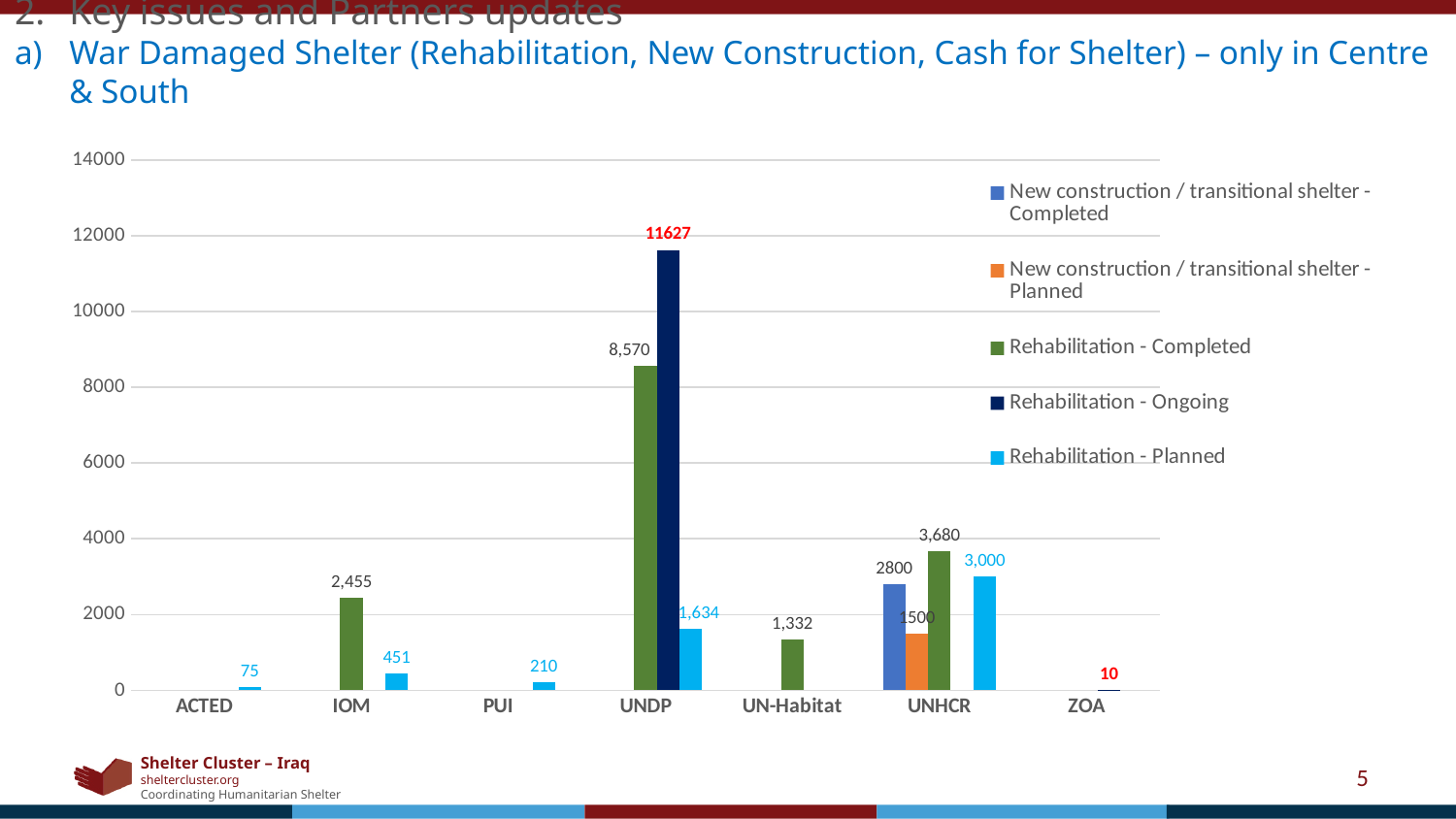
Which partner has the highest Rehabilitation - Completed value? UNDP How many partners are shown on the x axis? 7 What is the Rehabilitation - Planned value for UNHCR? 3,000 What kind of chart is shown on the slide? bar chart What is the Rehabilitation - Ongoing value for UNDP? 11627 Which is larger: UNHCR's Rehabilitation - Completed value or IOM's Rehabilitation - Completed value? UNHCR What is the difference between UNDP's Rehabilitation - Ongoing value and its Rehabilitation - Completed value? 3057 Is the Rehabilitation - Completed value for UN-Habitat greater or less than 2000? less How many series does the legend list? 5 Which partner has the lowest Rehabilitation - Planned value? ACTED What is the Rehabilitation - Completed value for IOM? 2,455 What is the New construction / transitional shelter - Completed value for UNHCR? 2800